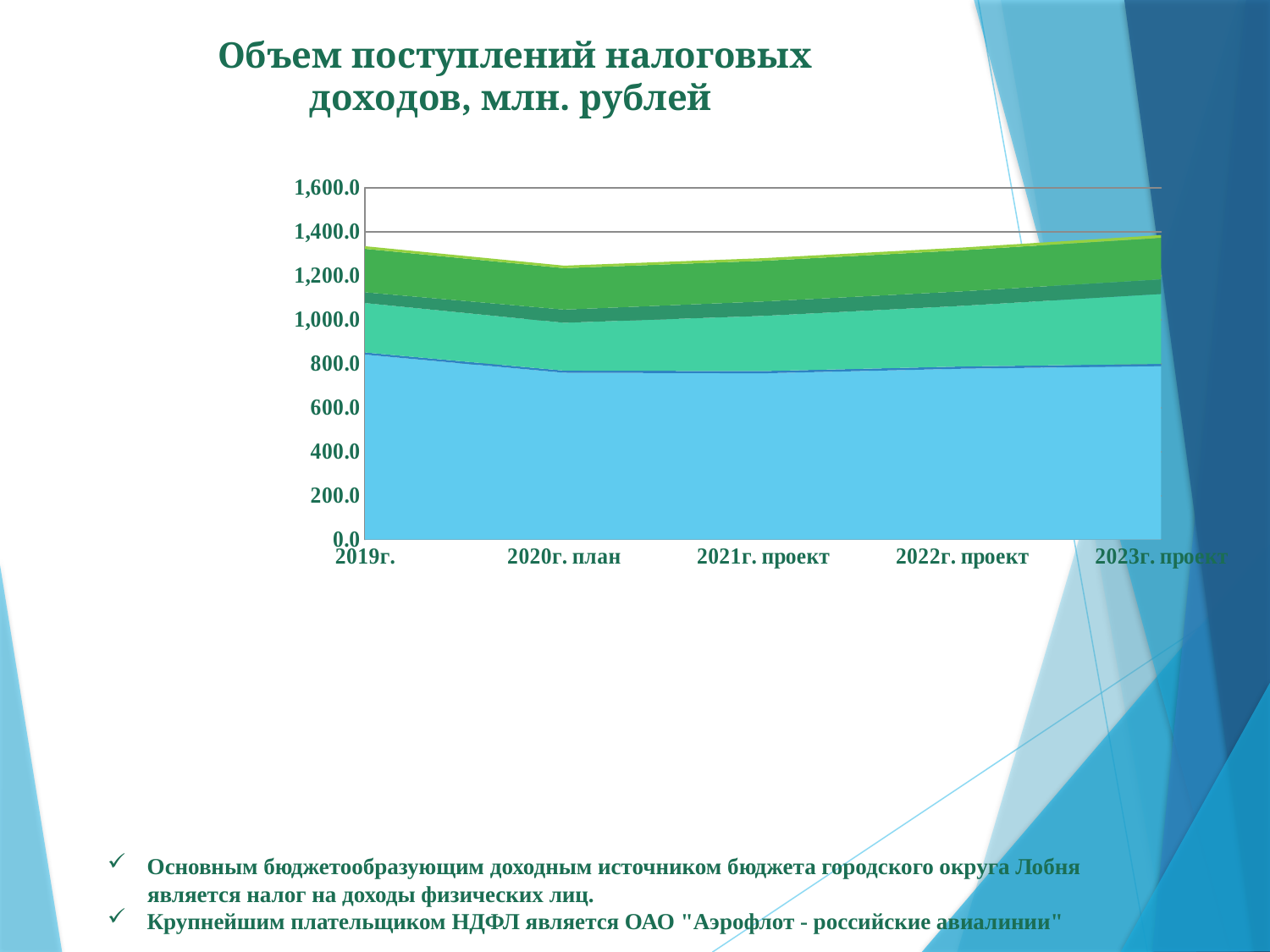
Is the value of the bottom (light blue) series for 2019г. greater or less than 800? greater How many categories are shown along the x axis? 5 Is the value of the bottom (light blue) series for 2021г. проект greater or less than 800? less What kind of chart is shown on the slide? area chart Which category has the highest value for the bottom (light blue) series? 2019г. Is the total stacked value larger for 2023г. проект or for 2020г. план? 2023г. проект What is the highest value shown on the y axis? 1,600.0 Is the total stacked value for 2019г. greater or less than 1,200? greater Which category has the lowest total stacked value? 2020г. план How does the total stacked value change from 2020г. план to 2023г. проект? it rises What is the title of the chart? Объем поступлений налоговых доходов, млн. рублей